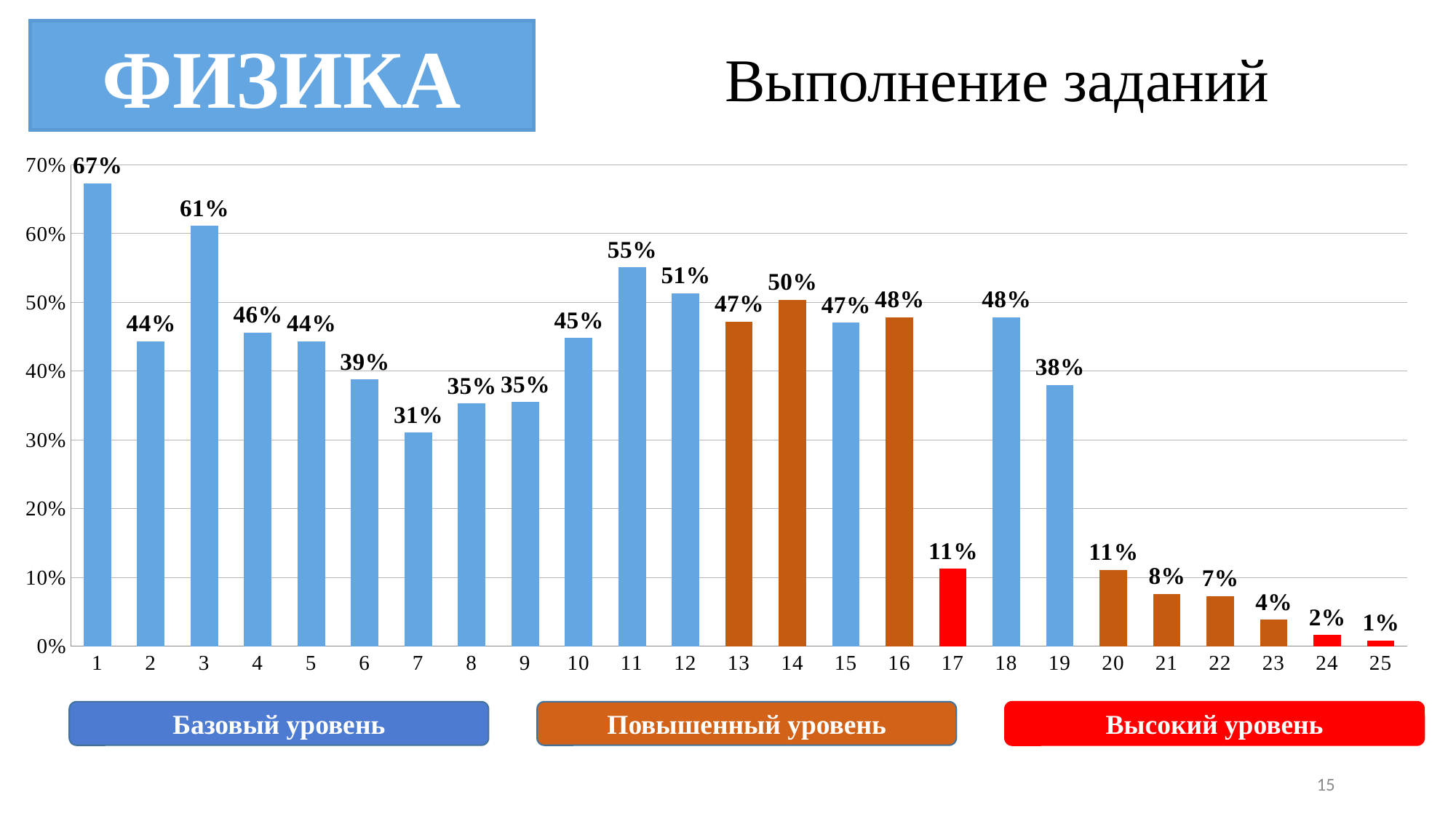
What is the difference between the values for task 1 and task 3? 6% Which task has the lowest value? 25 How many tasks are shown on the x axis? 25 Which level do the red bars represent according to the legend? Высокий уровень Do the values rise or fall from task 20 to task 25? fall Which task has the highest value? 1 Which is larger, the value for task 12 or the value for task 19? task 12 What kind of chart is shown on the slide? bar chart What is the value for task 17? 11% What is the value for task 1? 67% What is the difference between the values for task 11 and task 7? 24% What is the value for task 14? 50%